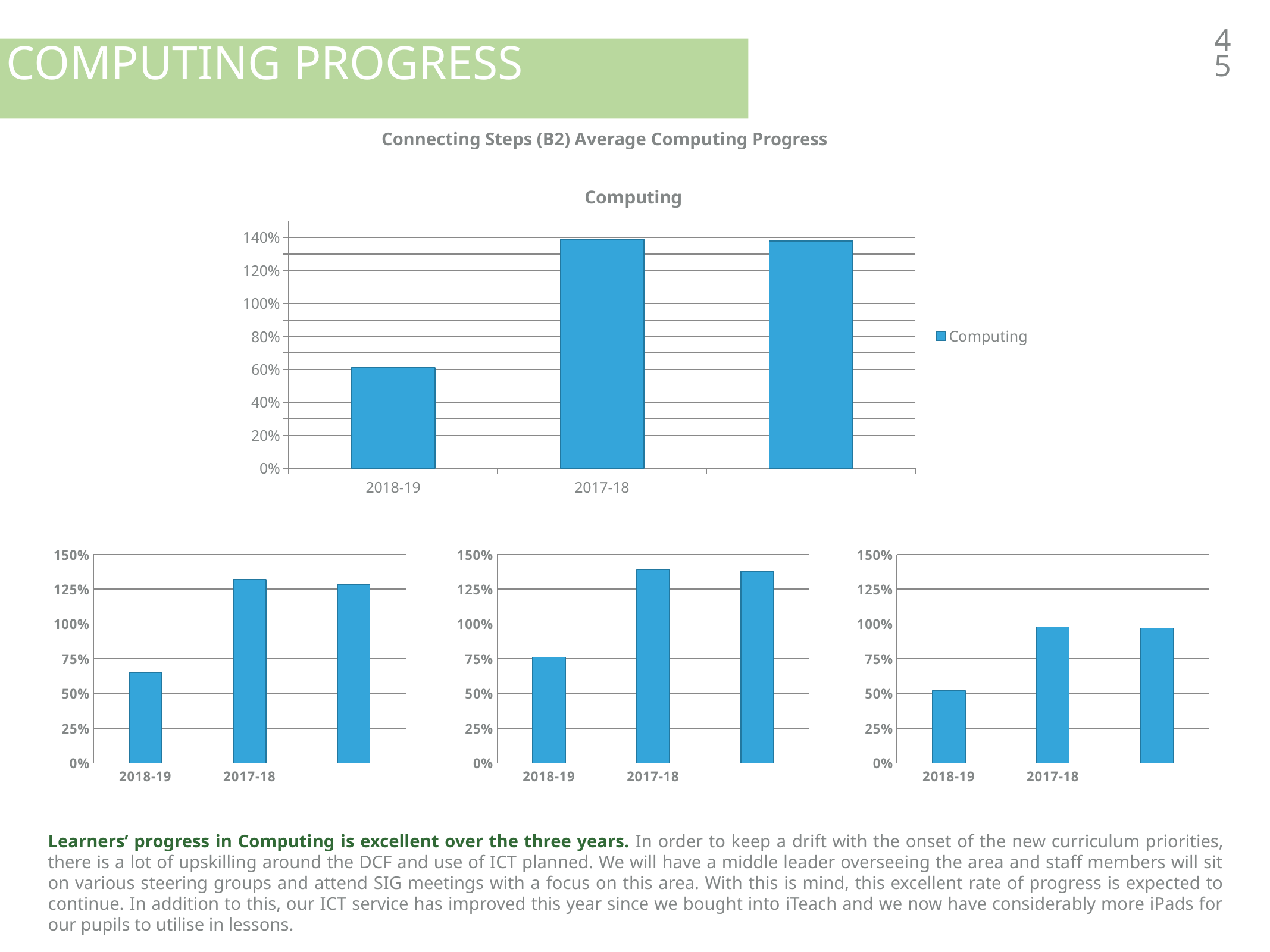
What is the title shown above the top chart on the slide? Connecting Steps (B2) Average Computing Progress In the top "Computing" chart, which is larger, the value for 2018-19 or the value for 2017-18? 2017-18 In the top "Computing" chart, is the value for 2018-19 greater or less than 80%? less How many series does the legend of the top "Computing" chart list? 1 In the top "Computing" chart, which labelled year has the lowest value? 2018-19 In the bottom-right chart, which is larger, the value for 2018-19 or the value for 2017-18? 2017-18 In the bottom-left chart, is the value for 2018-19 greater or less than 50%? greater What kind of chart is the top chart titled "Computing"? bar chart In the top "Computing" chart, is the value for 2017-18 greater or less than 120%? greater How many bars are plotted in the top "Computing" chart? 3